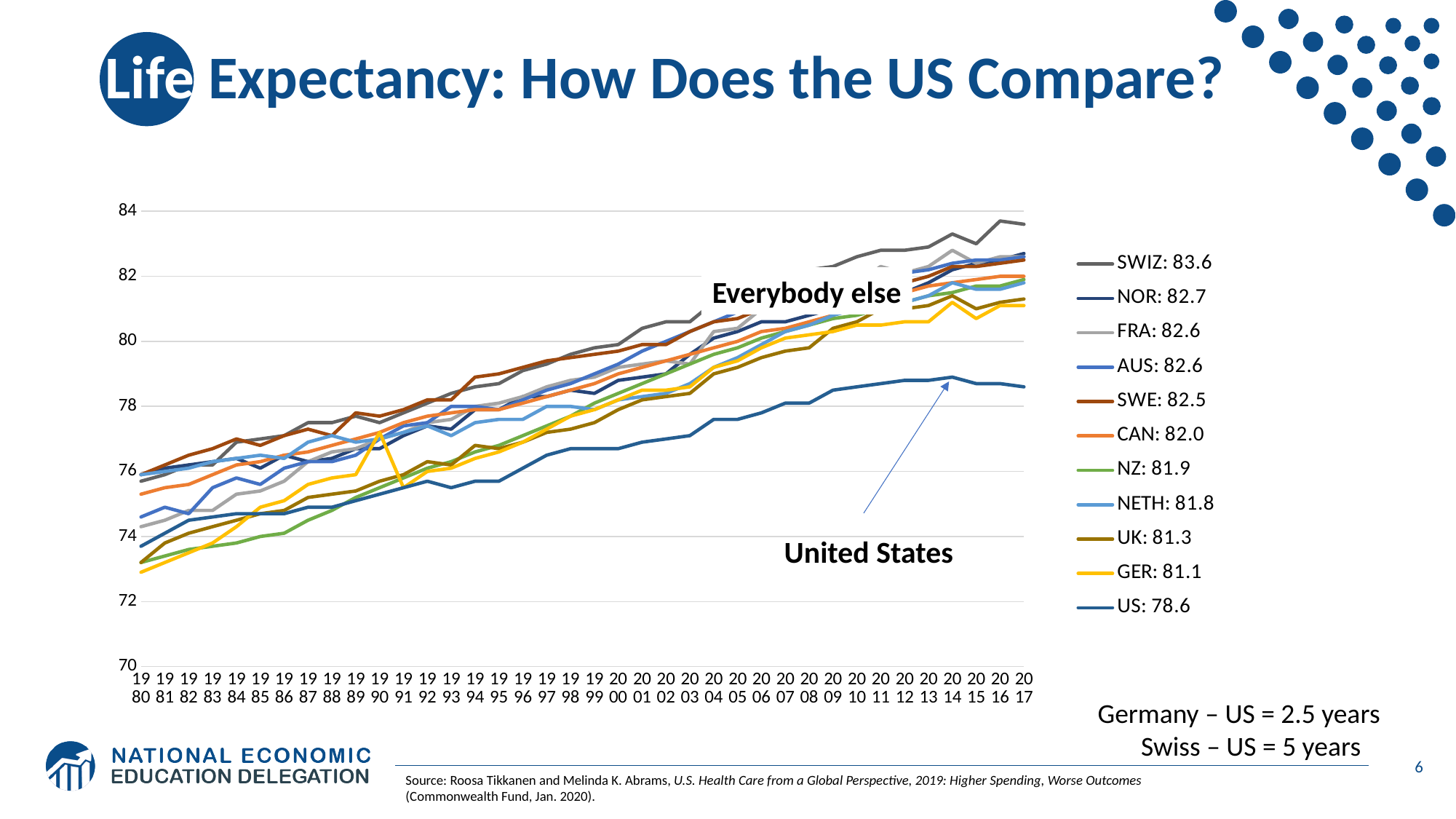
Is the US value in 2017 greater or less than 80? less Which country has the lowest life expectancy value in the legend? US What is the difference between the GER and US legend values? 2.5 What life expectancy value is shown for SWIZ in the legend? 83.6 How many series does the legend list? 11 What life expectancy value is shown for the US in the legend? 78.6 Which country has the highest life expectancy value in the legend? SWIZ Does the US line rise or fall from 1980 to 2017? rise What life expectancy value is shown for GER in the legend? 81.1 Which has a higher legend value, CAN or NZ? CAN What type of chart is shown on the slide? line chart What is the difference between the SWIZ and US legend values? 5.0